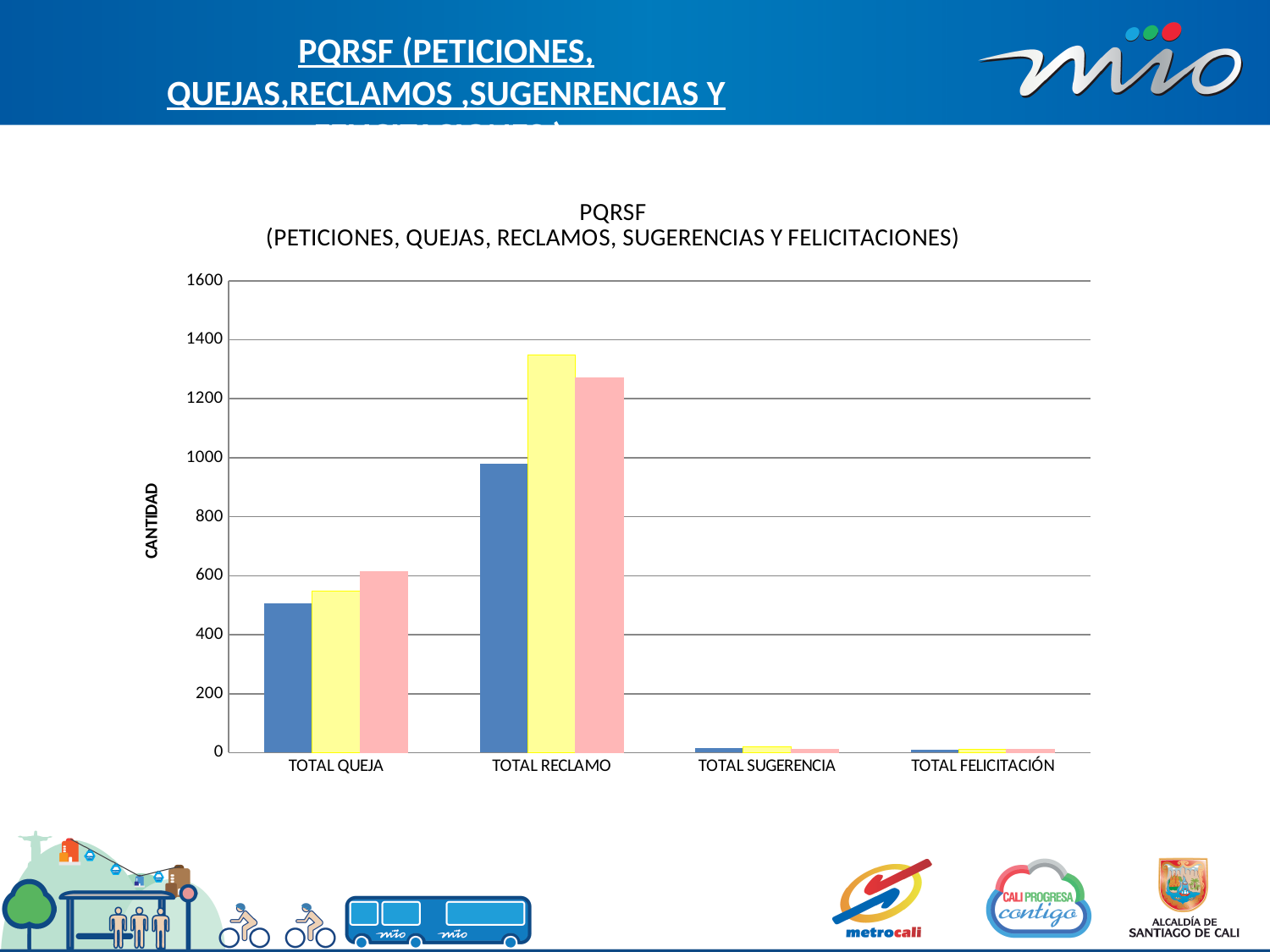
Is the value of the pink bar for TOTAL RECLAMO greater or less than 1400? less What is the title of the vertical axis of the chart? CANTIDAD Which category has higher values, TOTAL QUEJA or TOTAL RECLAMO? TOTAL RECLAMO Is the value of the blue bar for TOTAL QUEJA greater or less than 600? less Is the value of the blue bar for TOTAL QUEJA greater or less than 400? greater What kind of chart is shown on the slide? bar chart Which category has higher values, TOTAL SUGERENCIA or TOTAL RECLAMO? TOTAL RECLAMO How many categories are shown on the x axis of the chart? 4 How many bars are plotted for each category in the chart? 3 Which category has the highest bars in the chart? TOTAL RECLAMO